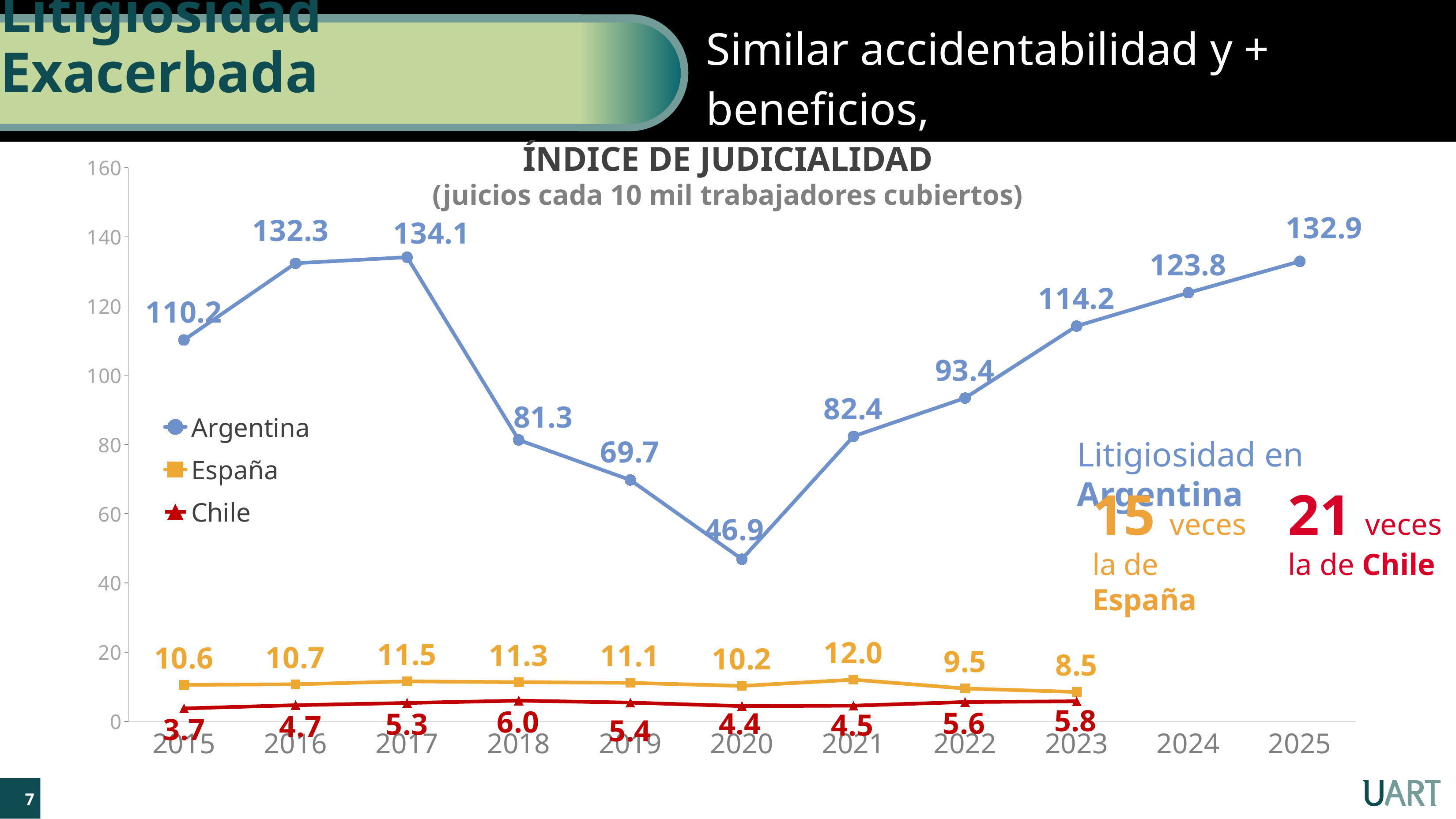
What is the value for Chile in 2018? 6.0 In which year does Argentina reach its highest value? 2017 What is the difference between Argentina's value in 2017 and its value in 2020? 87.2 What is the value for Argentina in 2020? 46.9 Does the Argentina series rise or fall from 2020 to 2025? rise In which year does Chile have its lowest value? 2015 How many series does the legend list? 3 Which is larger, España's value in 2023 or Chile's value in 2023? España's value in 2023 What is the value for España in 2021? 12.0 What kind of chart is shown on the slide? line chart How many years are shown on the x axis? 11 Is the value for Argentina in 2024 greater or less than 120? greater